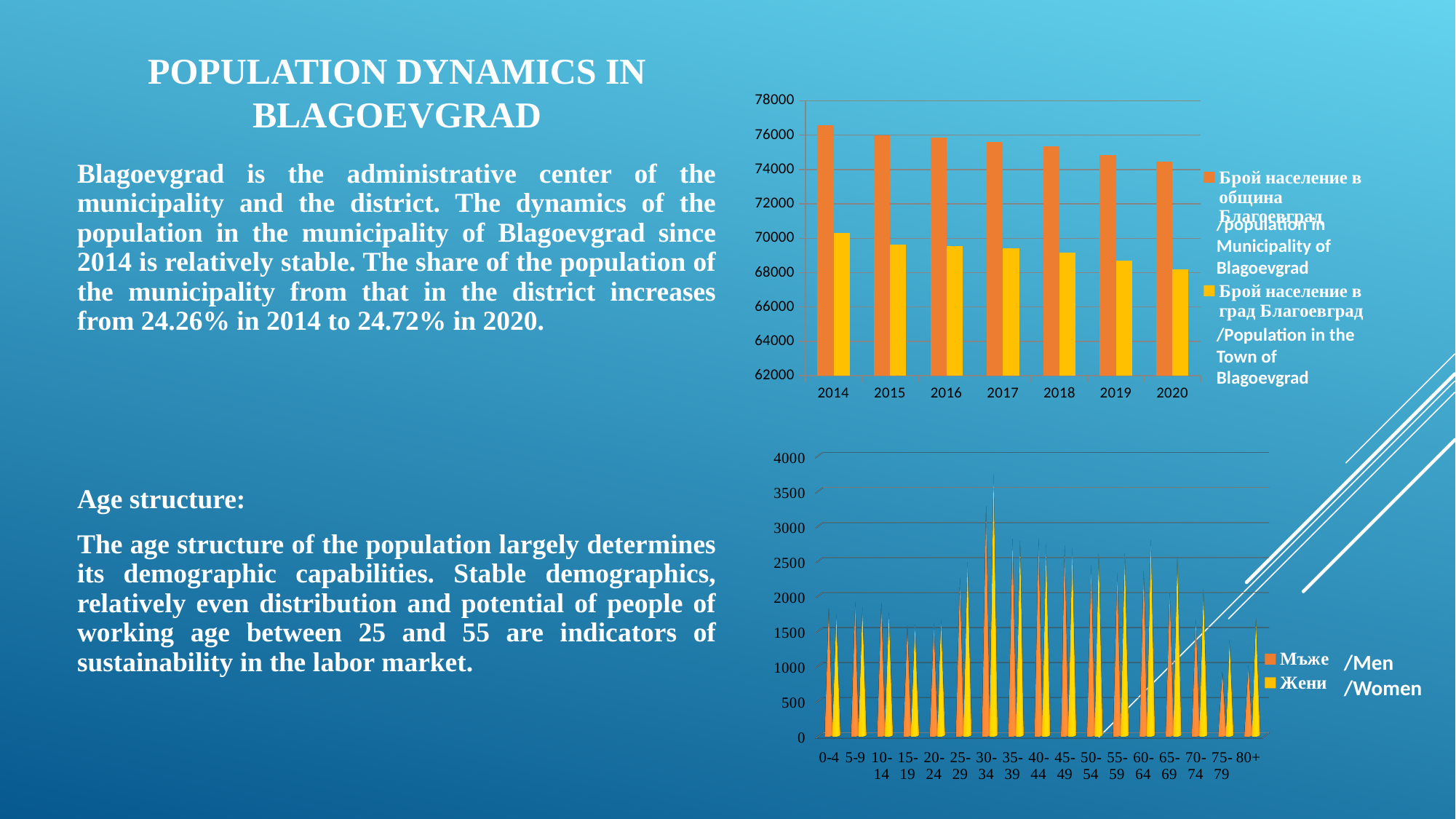
In the top chart (population 2014–2020), is the population in the Town of Blagoevgrad in 2020 greater or less than 70000? less In the top chart (population 2014–2020), how many years are shown on the x axis? 7 In the bottom chart (age structure), which age group has the highest value? 30-34 In the top chart (population 2014–2020), is the population in the Municipality of Blagoevgrad in 2014 greater or less than 76000? greater In the top chart (population 2014–2020), how many series does the legend list? 2 In the top chart (population 2014–2020), which is larger in 2018: the population in the Municipality of Blagoevgrad or the population in the Town of Blagoevgrad? Population in the Municipality of Blagoevgrad What kind of chart is the top chart on the slide (population 2014–2020)? bar chart In the top chart (population 2014–2020), which year has the lowest population in the Town of Blagoevgrad? 2020 In the top chart (population 2014–2020), does the population in the Municipality of Blagoevgrad rise or fall from 2014 to 2020? fall In the bottom chart (age structure), how many series does the legend list? 2 In the bottom chart (age structure), how many age groups are shown on the x axis? 17 In the top chart (population 2014–2020), which year has the highest population in the Municipality of Blagoevgrad? 2014